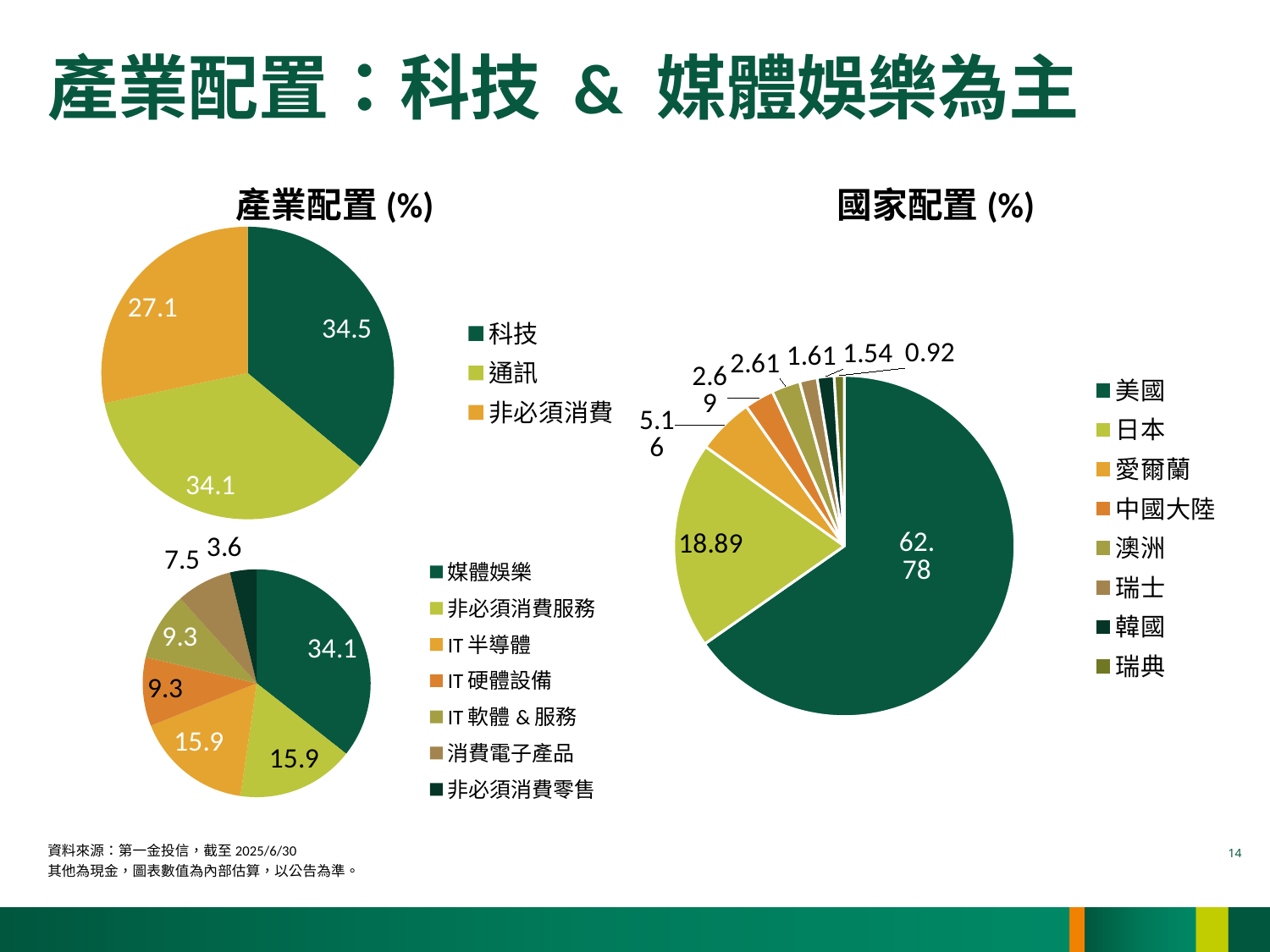
In the bottom-left pie chart, what is the value for 媒體娛樂? 34.1 In the 國家配置 (%) pie chart, what is the value for 日本? 18.89 In the 產業配置 (%) pie chart, what is the difference between 科技 and 非必須消費? 7.4 In the 產業配置 (%) pie chart, what is the value for 科技? 34.5 In the 產業配置 (%) pie chart, which category has the largest share? 科技 In the 國家配置 (%) pie chart, which is larger, 瑞士 or 瑞典? 瑞士 How many categories does the legend of the 產業配置 (%) pie chart list? 3 In the bottom-left pie chart, what is the value for 消費電子產品? 7.5 In the 國家配置 (%) pie chart, what is the value for 美國? 62.78 In the 產業配置 (%) pie chart, what is the value for 非必須消費? 27.1 In the bottom-left pie chart, which category has the smallest share? 非必須消費零售 How many categories does the legend of the bottom-left pie chart list? 7